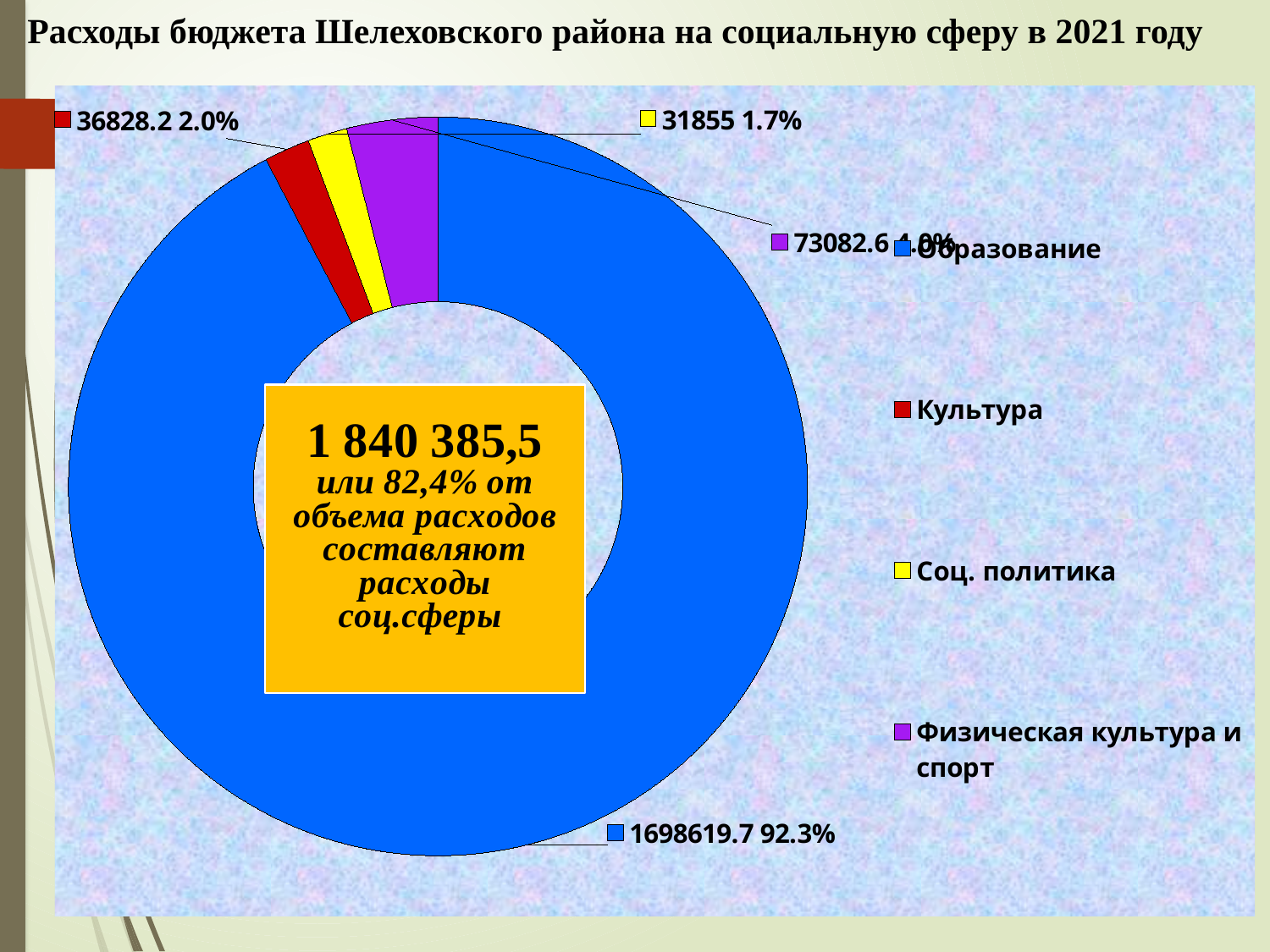
Which category has the largest share of the chart? Образование What is the value shown for Физическая культура и спорт? 73082.6 How many categories does the legend list? 4 What is the value shown for Соц. политика? 31855 What kind of chart is shown on the slide? Doughnut (pie) chart What percentage share does Образование have? 92.3% What is the value shown for Образование? 1698619.7 What is the value shown for Культура? 36828.2 Which category has the smallest share of the chart? Соц. политика What percentage share does Культура have? 2.0% Which is larger, the value for Культура or the value for Соц. политика? Культура What percentage share does Соц. политика have? 1.7%